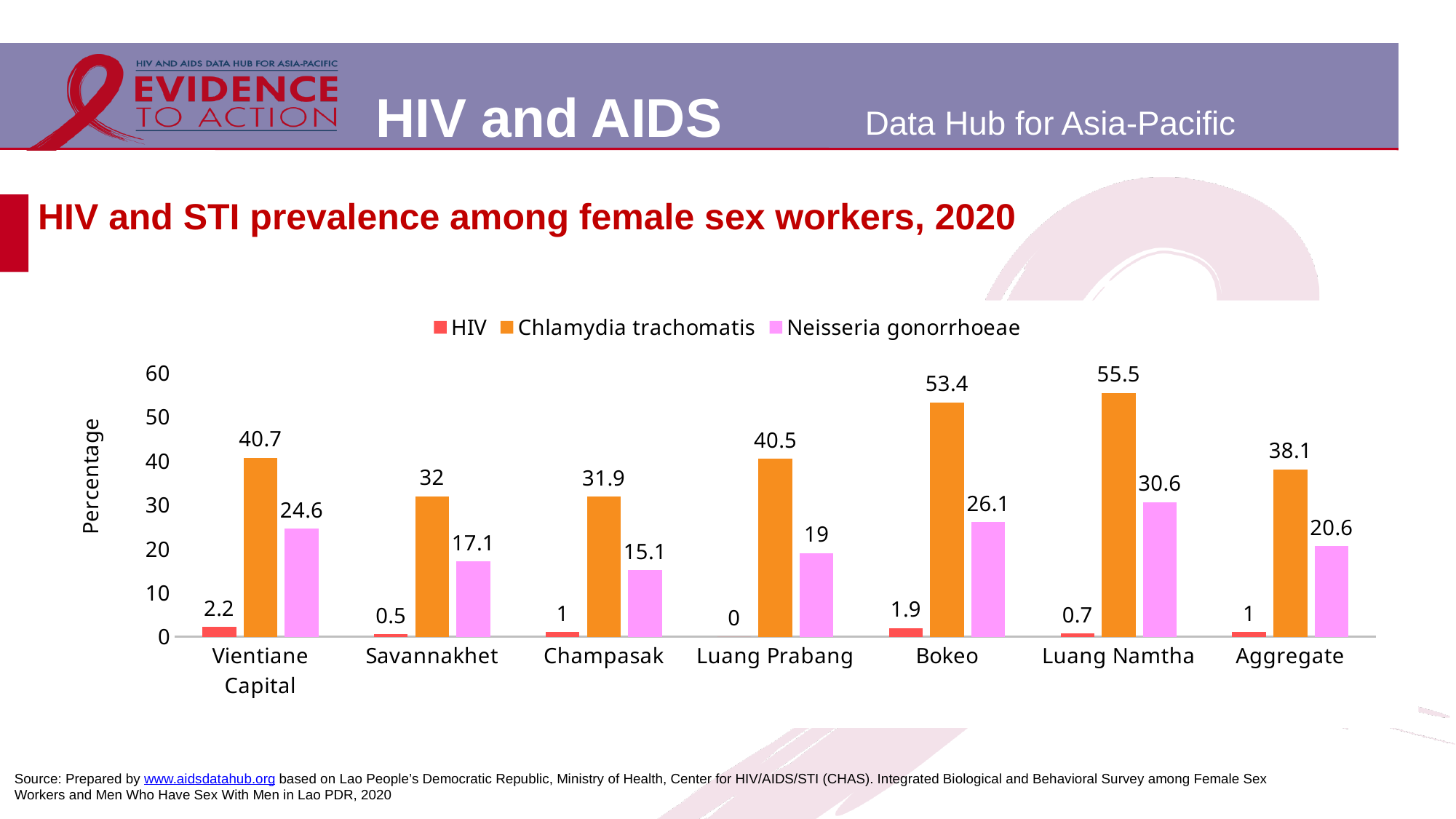
Which province has the lowest HIV prevalence? Luang Prabang What kind of chart is shown on the slide? Bar chart How many series does the legend list? 3 What is the difference between the Chlamydia trachomatis and Neisseria gonorrhoeae values for Aggregate? 17.5 What is the label on the y axis? Percentage What is the Chlamydia trachomatis prevalence for Luang Namtha? 55.5 What is the Neisseria gonorrhoeae prevalence for Bokeo? 26.1 What is the HIV prevalence for Vientiane Capital? 2.2 Which province has the highest Chlamydia trachomatis prevalence? Luang Namtha Is the Chlamydia trachomatis value for Bokeo greater or less than 50? greater Which is larger, the Neisseria gonorrhoeae value for Vientiane Capital or for Savannakhet? Vientiane Capital How many categories are shown on the x axis? 7